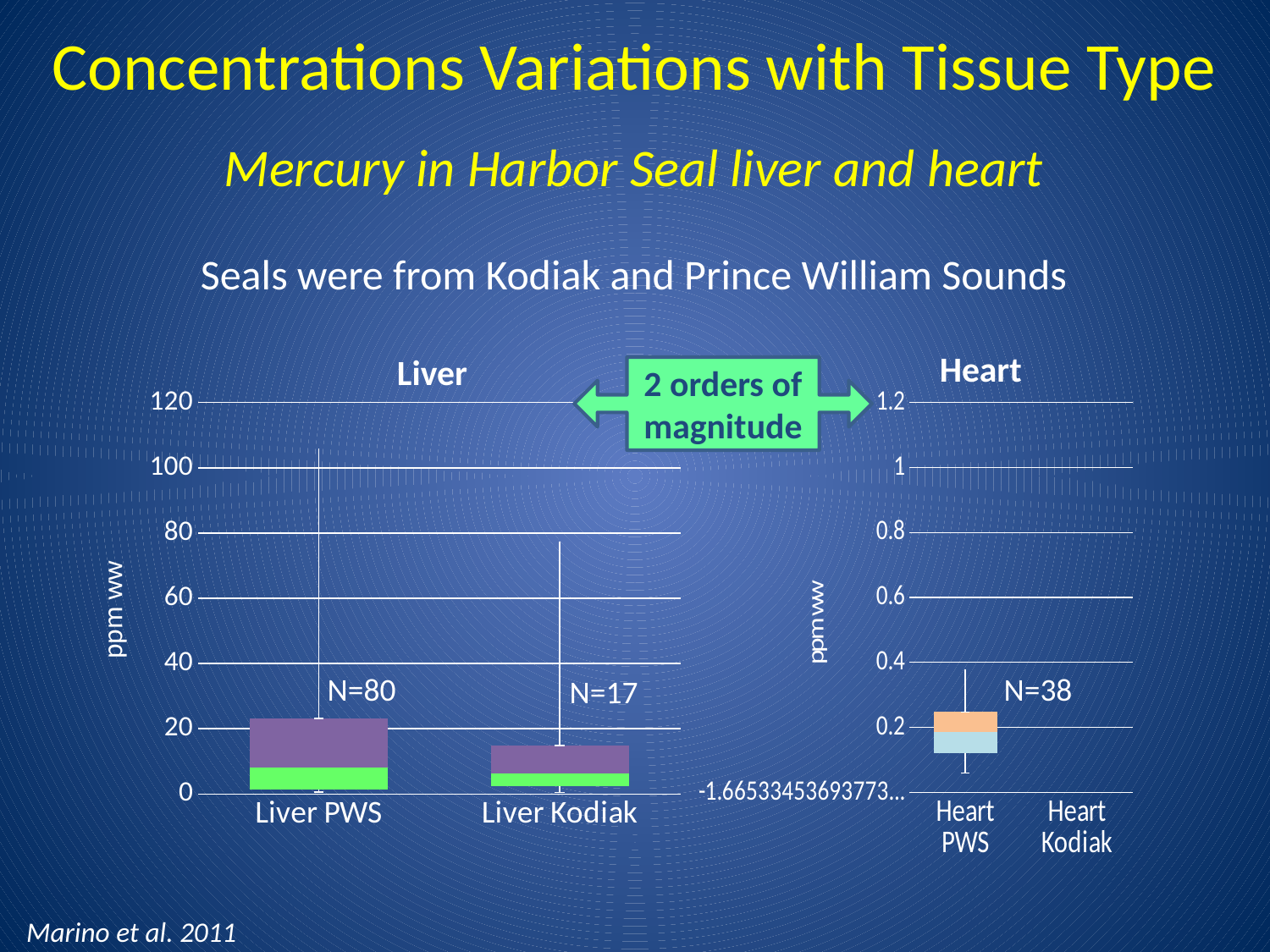
On the Liver chart, what is the y-axis title? ppm ww On the Liver chart, what is the sample size label shown for Liver Kodiak? N=17 On the Heart chart, what sample size label is shown? N=38 On the Liver chart, is the top of the upper whisker for Liver Kodiak greater or less than 60? greater On the Liver chart, what is the sample size label shown for Liver PWS? N=80 On the Liver chart, what is the highest value labelled on the y axis? 120 On the Liver chart, is the top of the Liver PWS box greater or less than 40? less On the Liver chart, is the top of the upper whisker for Liver PWS greater or less than 80? greater On the Heart chart, what is the highest value labelled on the y axis? 1.2 On the Liver chart, which category has the higher top of its box, Liver PWS or Liver Kodiak? Liver PWS On the Liver chart, how many categories are shown on the x axis? 2